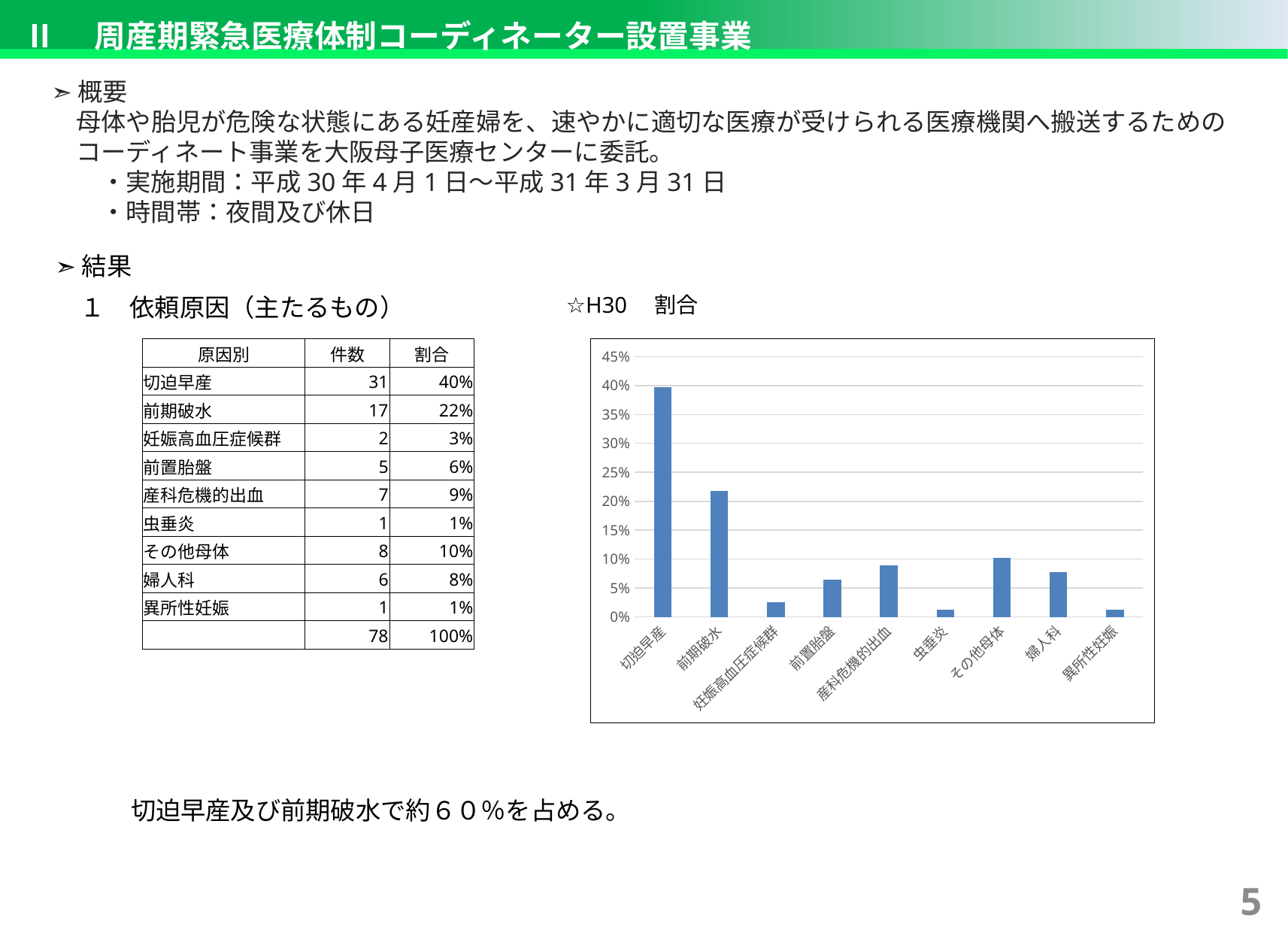
How many categories are plotted on the x axis of the chart? 9 Which bar is taller, 産科危機的出血 or 前置胎盤? 産科危機的出血 According to the slide, what is the 割合 for 前置胎盤? 6% According to the slide, what is the 割合 for 切迫早産? 40% Which bar is taller, 前期破水 or その他母体? 前期破水 Is the bar for 前期破水 greater or less than 25%? less What is the difference between the 割合 for 切迫早産 and 前期破水 as printed on the slide? 18% What kind of chart is shown on the slide? bar chart What is the highest tick value shown on the chart's vertical axis? 45% Which category has the highest bar in the chart? 切迫早産 Is the bar for 切迫早産 greater or less than 35%? greater Is the bar for その他母体 greater or less than 5%? greater